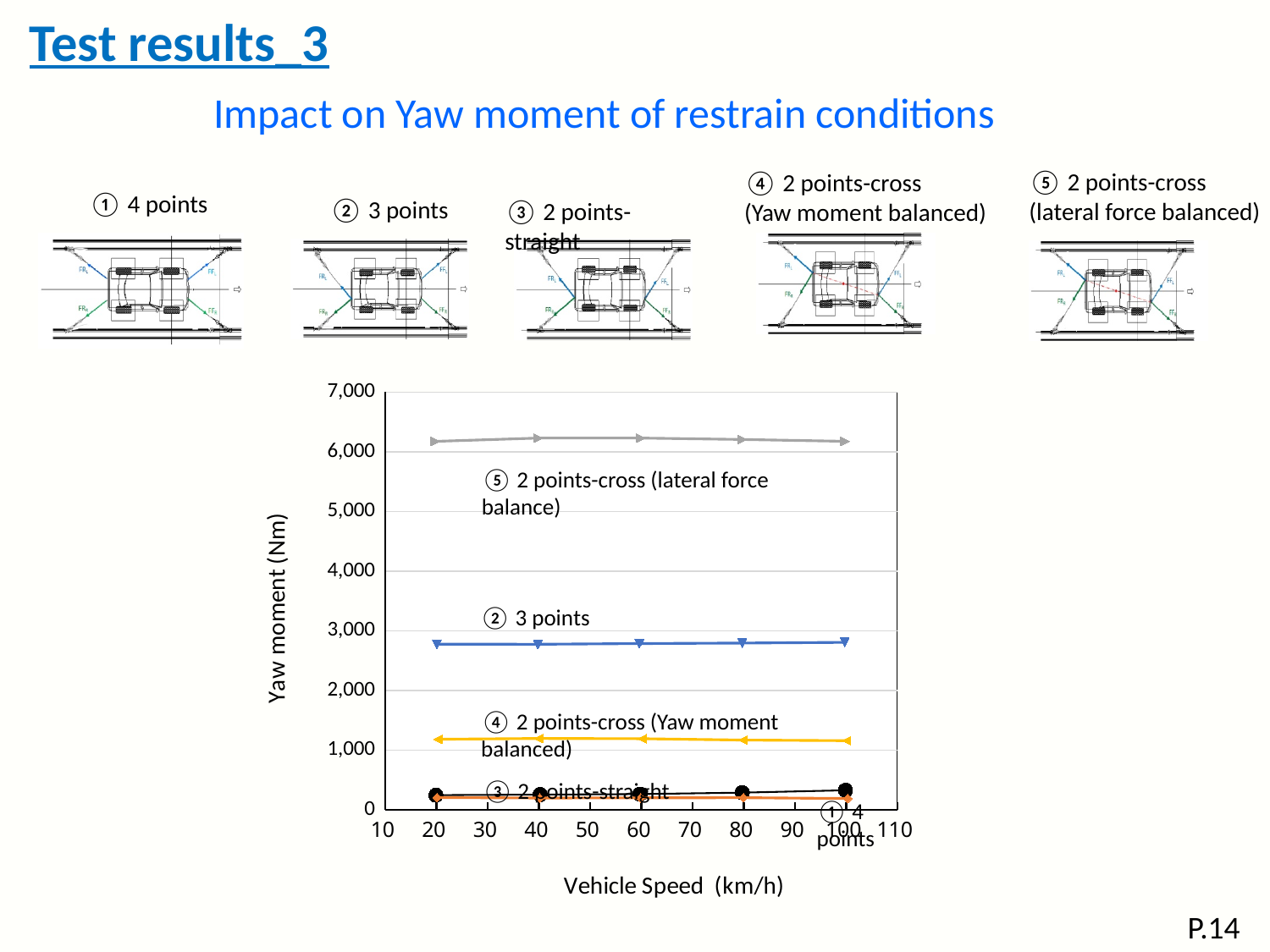
What is the label of the y axis of the chart? Yaw moment (Nm) Is the yaw moment for ② 3 points at 60 km/h greater or less than 3,000 Nm? less Which has the larger yaw moment at 80 km/h: ② 3 points or ④ 2 points-cross (Yaw moment balanced)? ② 3 points What kind of chart is shown on the slide? line chart Is the yaw moment for ④ 2 points-cross (Yaw moment balanced) at 40 km/h greater or less than 1,000 Nm? greater Which restraint condition has the highest yaw moment across all speeds? ⑤ 2 points-cross (lateral force balance) How many restraint conditions are plotted on the chart? 5 What is the label of the x axis of the chart? Vehicle Speed (km/h) Is the yaw moment for ② 3 points at 40 km/h greater or less than 2,000 Nm? greater How many vehicle speed points are plotted for each restraint condition? 5